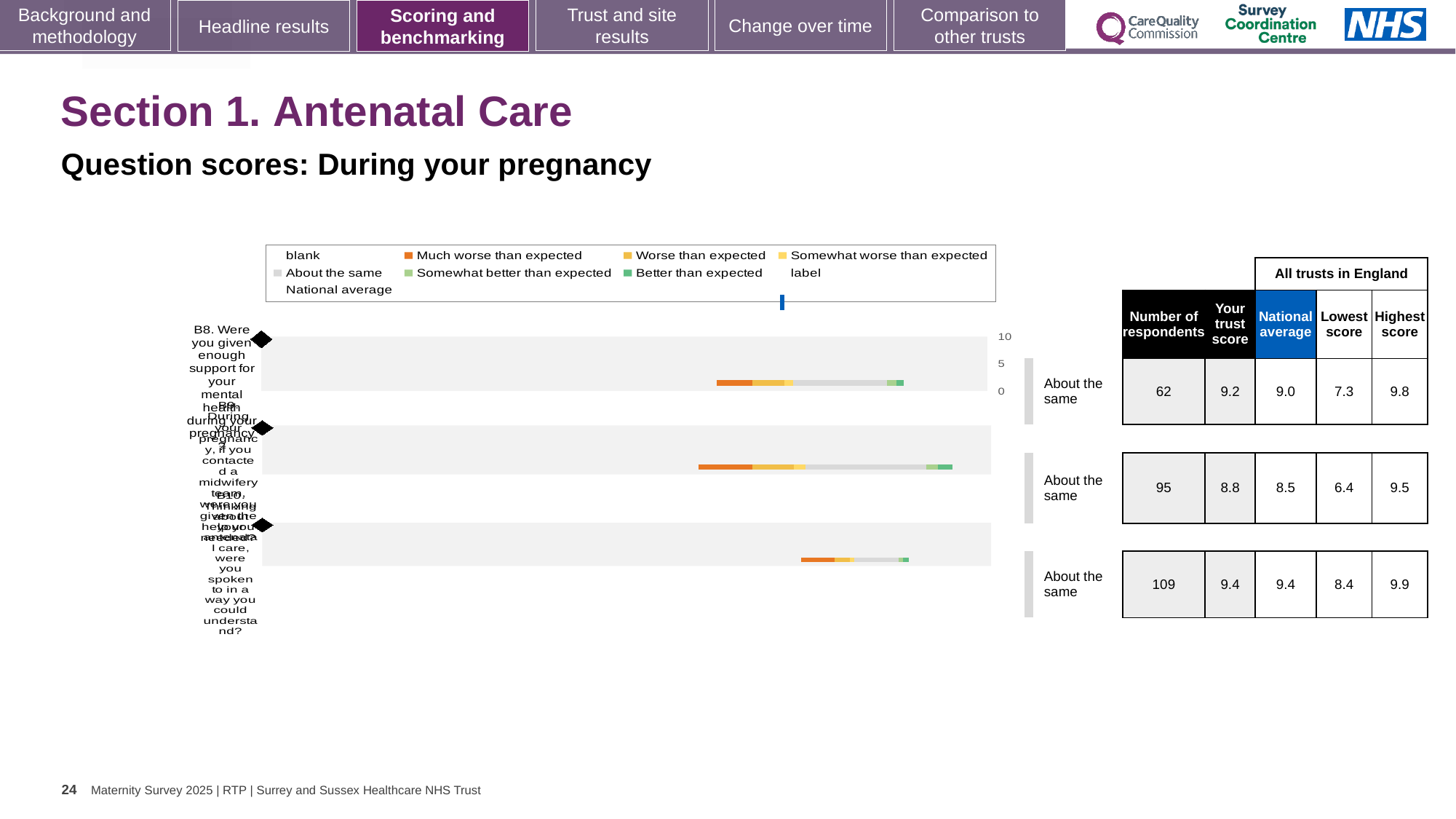
What is the number of respondents for the first row (B8, support for your mental health during pregnancy)? 62 Which row has the highest number of respondents? the third row (109) What is the difference between the highest score and the lowest score for the first row (B8)? 2.5 What is the trust score for the first row (B8, support for your mental health during pregnancy)? 9.2 For the second row, is the trust score or the national average larger? the trust score (8.8) What kind of chart is shown on the slide? bar chart How many question rows are plotted in the chart? 3 What is the lowest score among all trusts in England for the third row of the chart? 8.4 Which row has the lowest trust score? the second row (8.8) What is the national average for the first row (B8)? 9.0 What benchmark category is shown for all three rows? About the same What is the highest score among all trusts in England for the second row of the chart? 9.5